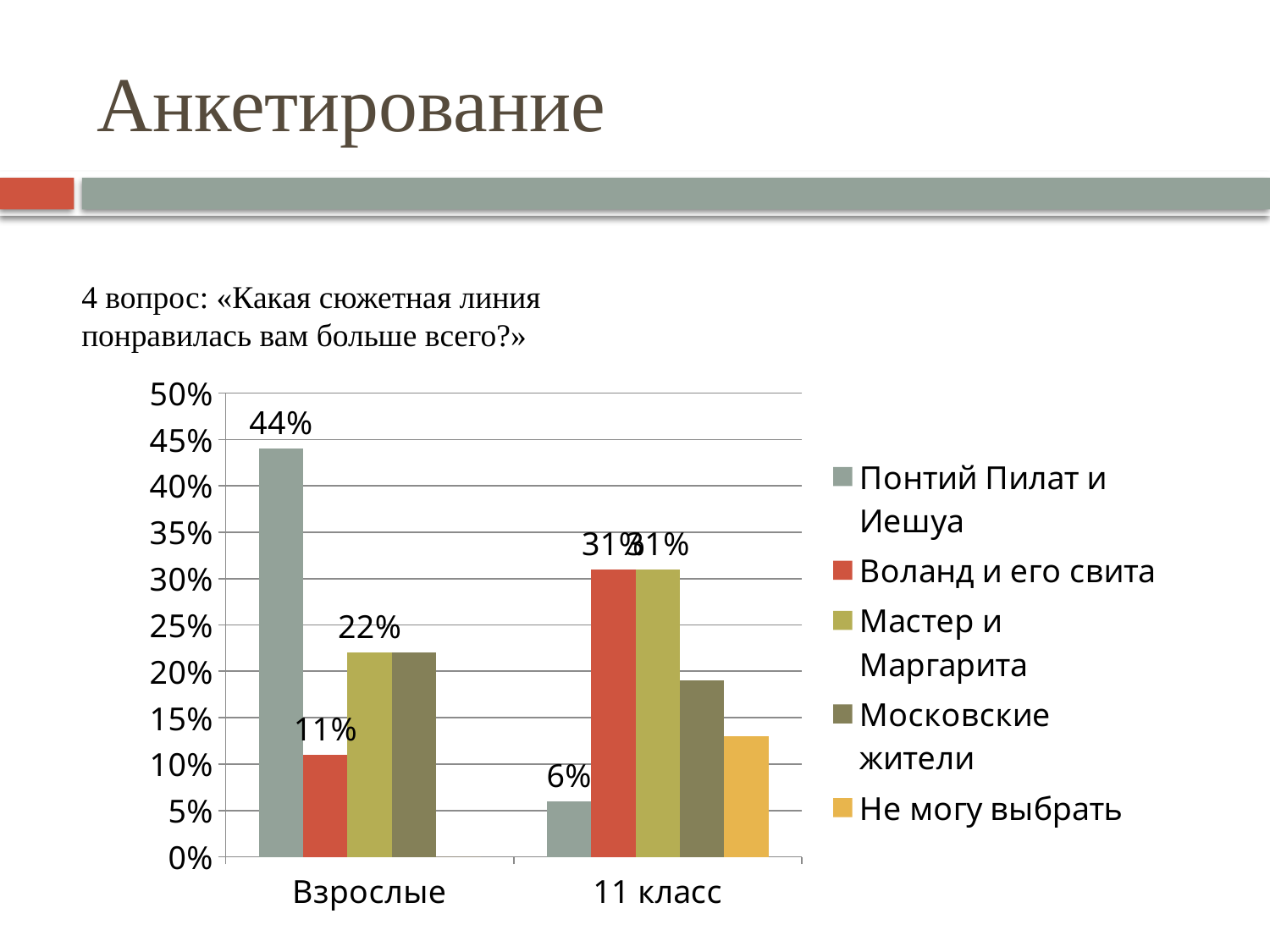
What is the value for Мастер и Маргарита in the Взрослые category? 22% How many series does the legend list? 5 What is the value for Воланд и его свита in the Взрослые category? 11% Is the value for Понтий Пилат и Иешуа larger for Взрослые or for 11 класс? Взрослые What is the difference between Понтий Пилат и Иешуа and Воланд и его свита in the Взрослые category? 33% Is the value for Не могу выбрать in the 11 класс category greater or less than 15%? less Which series has the highest value in the Взрослые category? Понтий Пилат и Иешуа What is the value for Понтий Пилат и Иешуа in the 11 класс category? 6% What is the value for Понтий Пилат и Иешуа in the Взрослые category? 44% What is the value for Воланд и его свита in the 11 класс category? 31% What kind of chart is shown on the slide? bar chart Which series has the lowest value in the 11 класс category? Понтий Пилат и Иешуа